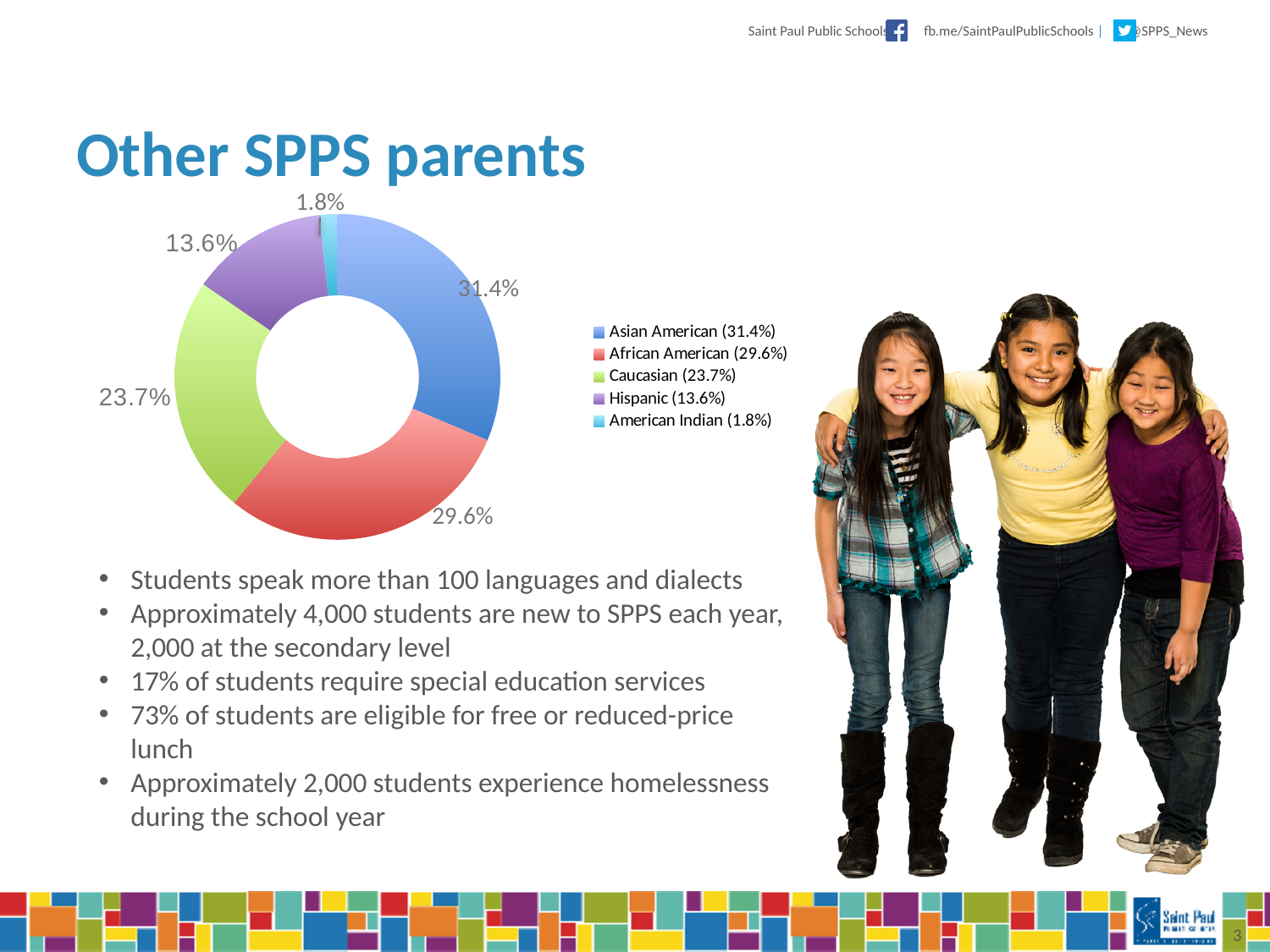
What colour represents Caucasian in the chart? Green What share of the chart is African American? 29.6% What share of the chart is American Indian? 1.8% What share of the chart is Asian American? 31.4% What kind of chart is shown on the slide? Doughnut (pie) chart What share of the chart is Caucasian? 23.7% Which is larger, the Caucasian share or the Hispanic share? Caucasian How many categories does the chart show? 5 What share of the chart is Hispanic? 13.6% Which category has the largest share of the chart? Asian American Which category has the smallest share of the chart? American Indian What is the difference between the Asian American and Hispanic shares? 17.8%